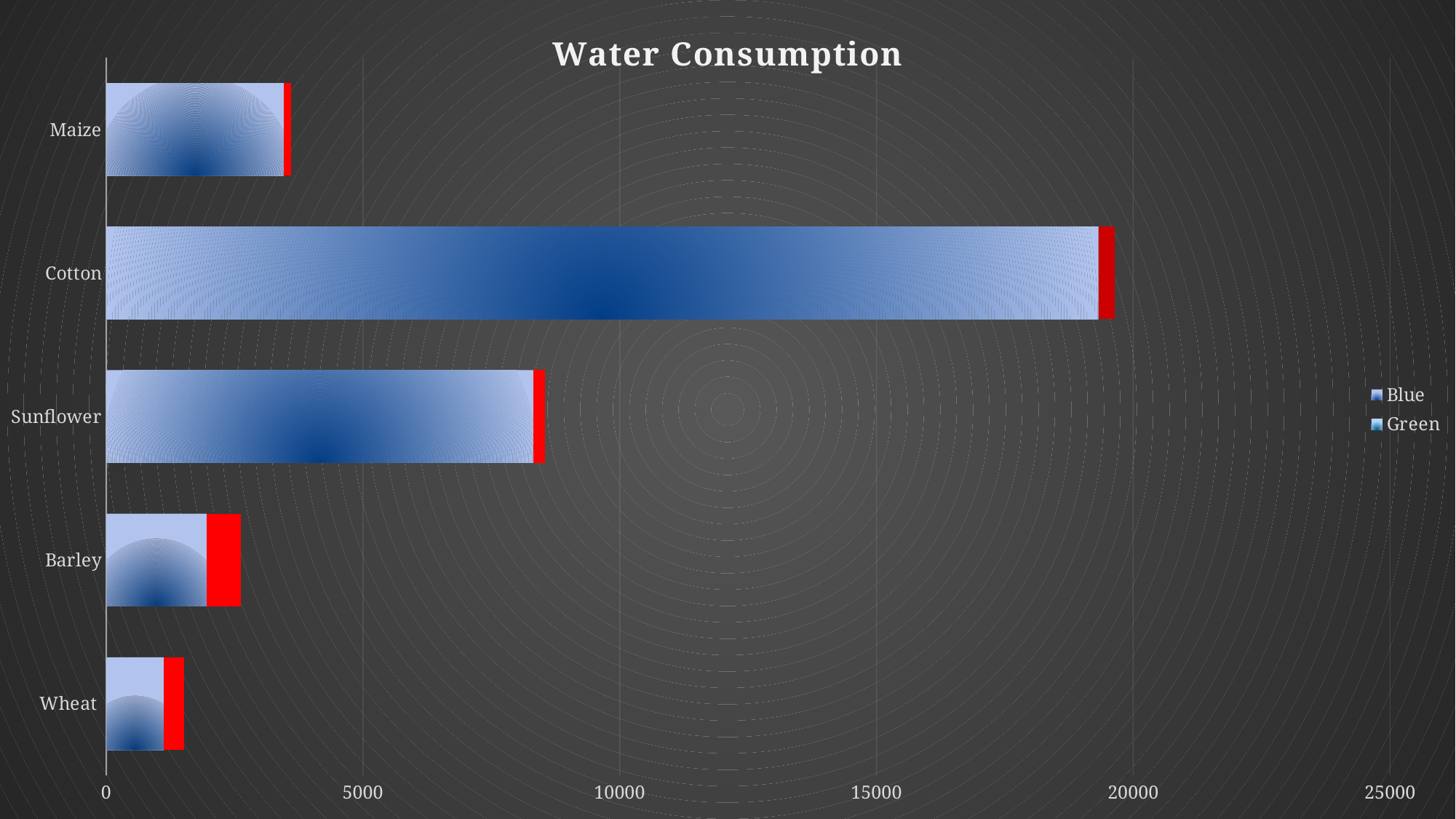
Which category has the shortest total bar? Wheat Is the Blue value for Cotton greater or less than 15000? greater Is the total bar for Maize greater or less than 5000? less Is the total bar for Cotton greater or less than 15000? greater How many series does the legend list? 2 How many categories are shown on the chart? 5 What is the title of the chart? Water Consumption Which category has the longest total bar? Cotton What kind of chart is shown on the slide? bar chart Which series are listed in the legend? Blue, Green Which has the larger total bar, Sunflower or Maize? Sunflower